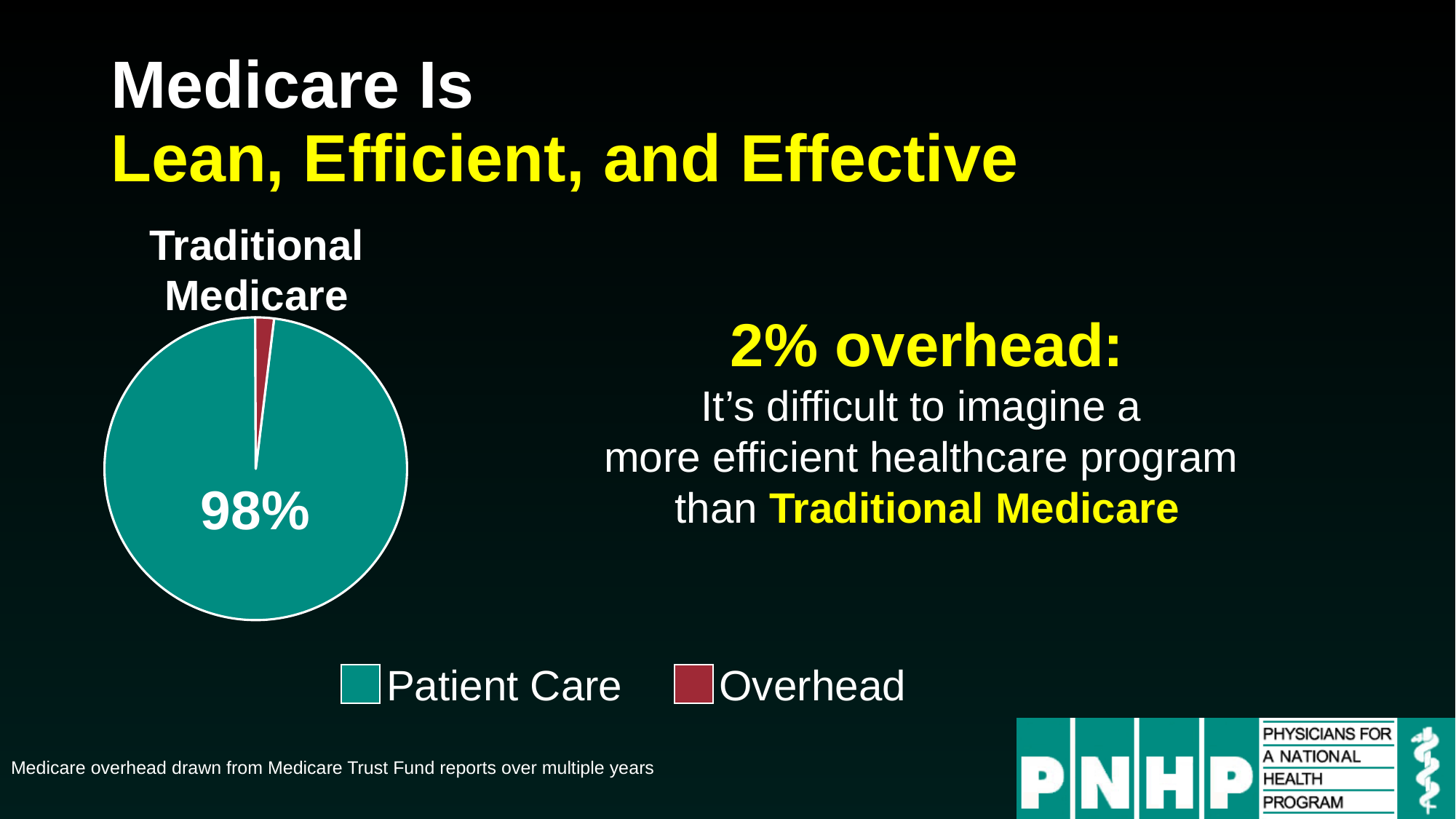
What share of the pie does Patient Care take? 98% What is the difference in percentage points between the Patient Care share and the Overhead share? 96 What percentage of Traditional Medicare spending goes to overhead, according to the slide? 2% Is the Patient Care share greater or less than 50%? greater How many slices does the pie chart have? 2 Which slice of the pie is the largest? Patient Care What kind of chart is shown on the slide? pie chart What colour represents Overhead in the pie chart? red What is the title of the pie chart? Traditional Medicare Which slice of the pie is the smallest? Overhead How many entries does the legend list? 2 Which is larger, the Patient Care slice or the Overhead slice? Patient Care